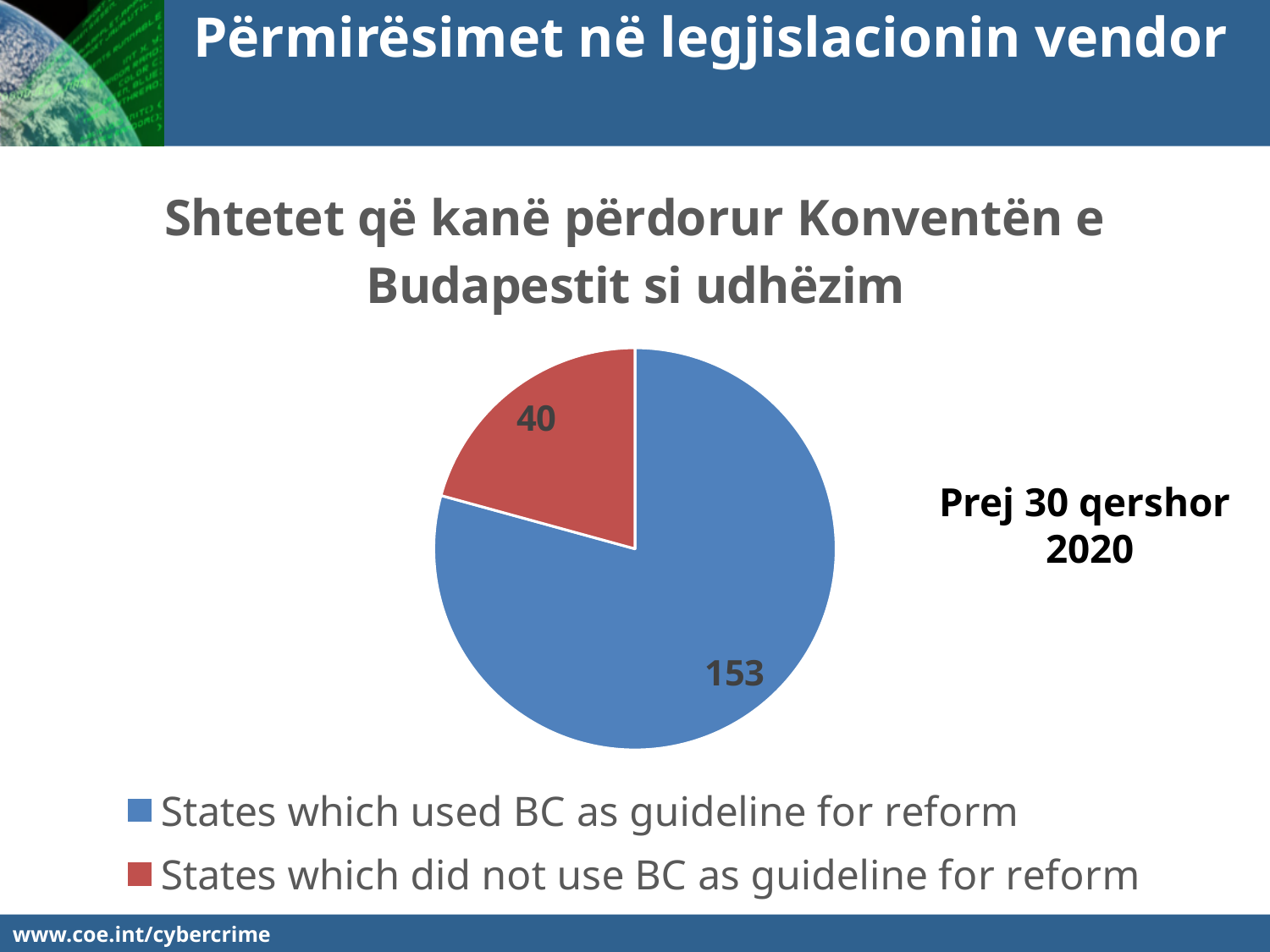
What colour is the slice for "States which used BC as guideline for reform"? Blue What type of chart is shown on the slide? Pie chart What is the value for "States which did not use BC as guideline for reform"? 40 What is the difference between the number of states which used BC as guideline for reform and those which did not? 113 Which is larger: the value for states which used BC as guideline for reform or the value for states which did not? States which used BC as guideline for reform How many slices does the pie chart have? 2 What is the value for "States which used BC as guideline for reform"? 153 How many entries does the legend list? 2 Which category has the smallest slice of the pie? States which did not use BC as guideline for reform What is the total of all slices in the pie chart? 193 Which category has the largest slice of the pie? States which used BC as guideline for reform